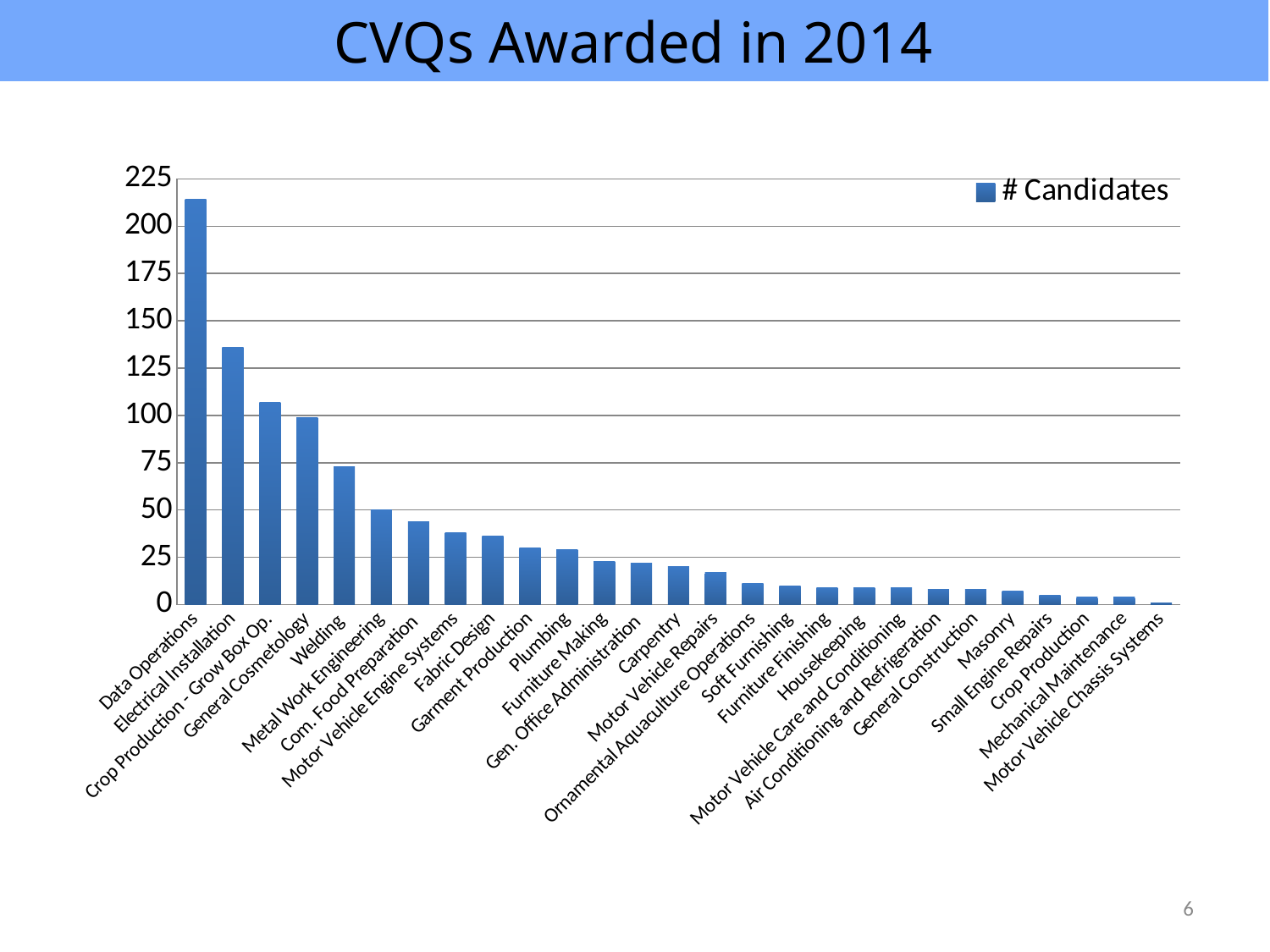
Which category has the highest number of candidates? Data Operations Is the value for Electrical Installation greater or less than 125? greater Which category has the lowest number of candidates? Motor Vehicle Chassis Systems What is the title of the chart? CVQs Awarded in 2014 How many categories are shown on the x axis? 27 How many series does the legend list? 1 Is the value for Data Operations greater or less than 200? greater Which has more candidates, Welding or Plumbing? Welding What type of chart is shown on the slide? bar chart Is the value for Com. Food Preparation greater or less than 50? less Do the values generally rise or fall from left to right along the x axis? fall